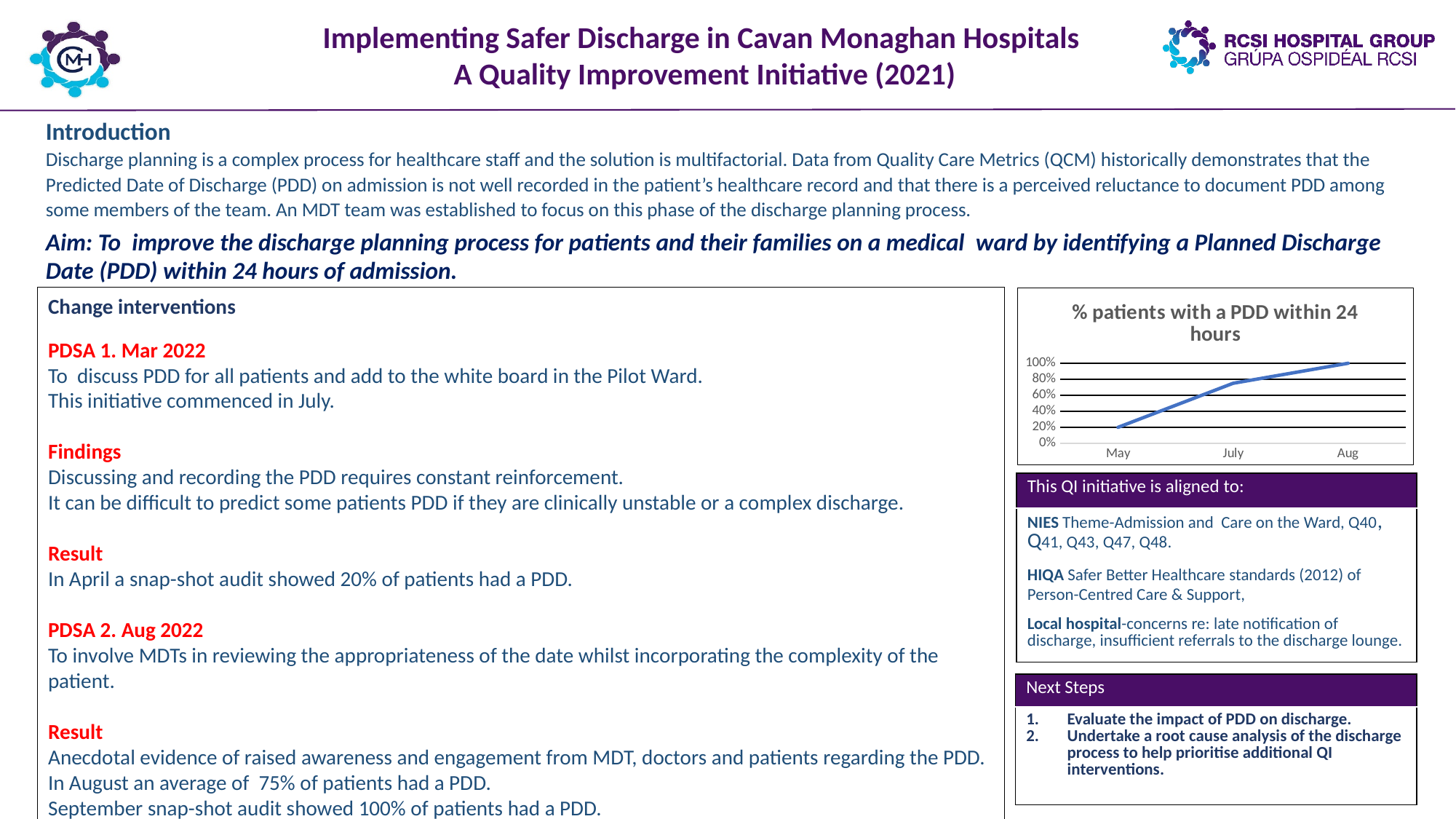
What is the title of the chart on the slide? % patients with a PDD within 24 hours What kind of chart is shown on the slide? line chart Is the value for July greater or less than 40%? greater What is the highest value shown on the chart's y axis? 100% Is the value for Aug greater or less than 80%? greater Which month has the lowest value in the chart? May Which month has the larger value in the chart, May or July? July Is the value for May greater or less than 40%? less How many months are plotted on the x axis of the chart? 3 Which month has the highest value in the chart? Aug Do the values in the chart rise or fall from May to Aug? rise